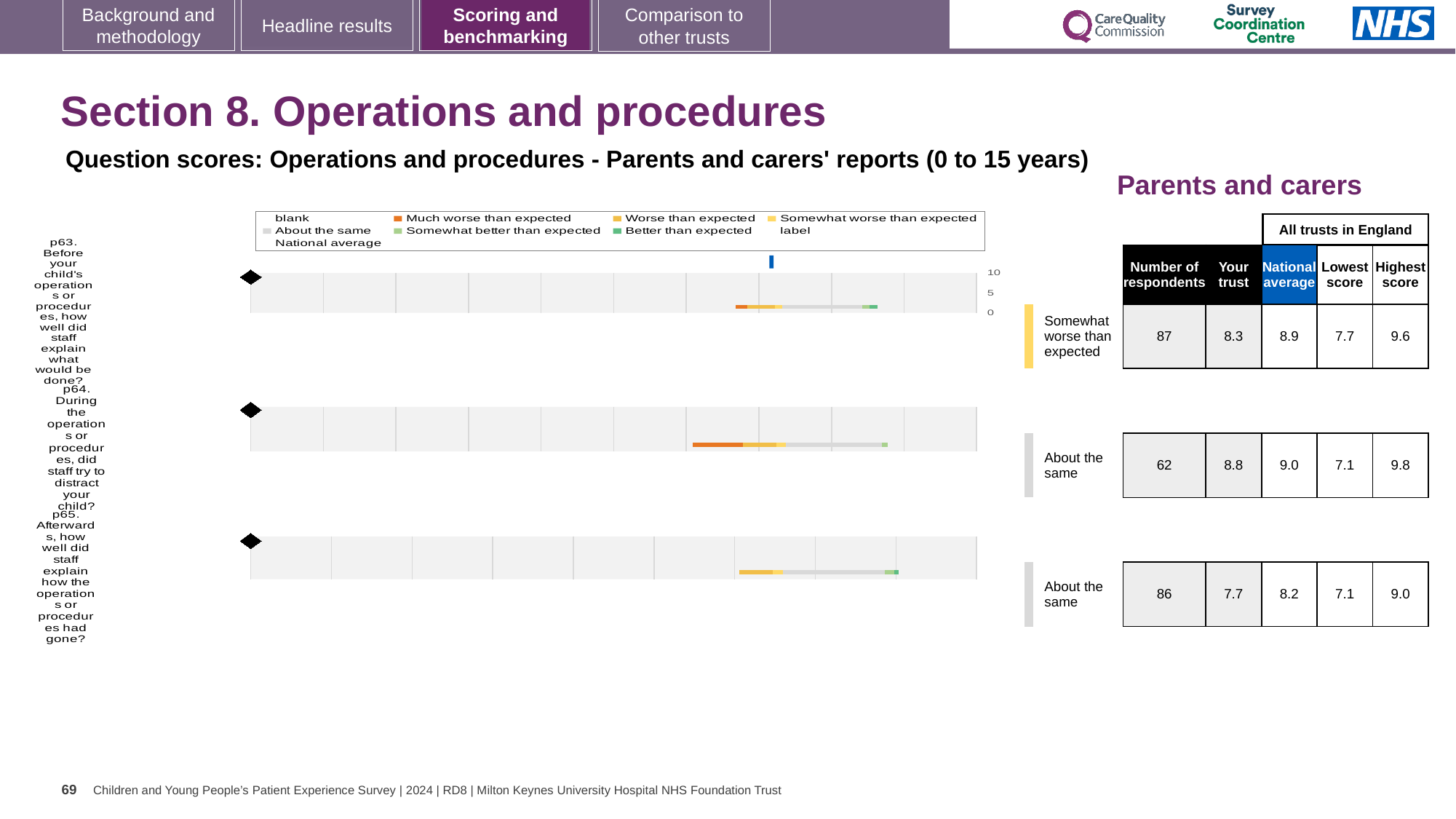
What benchmark category is shown for p64? About the same What kind of chart is used to show the question scores on this slide? bar chart How many questions (p63, p64, p65) are plotted on the slide? 3 Which question has the highest 'Your trust' score? p64 For p63, how much higher is the national average than the 'Your trust' score? 0.6 What is the highest score among all trusts in England for p64? 9.8 Which question has the lowest 'Your trust' score? p65 Which has the larger 'Your trust' score, p64 or p65? p64 How many respondents answered p65 (how well staff explained how the operation had gone)? 86 What is the national average score for p64 (did staff try to distract your child during the operation)? 9.0 What benchmark category is shown for p63? Somewhat worse than expected What is the 'Your trust' score for p63 (how well staff explained what would be done before the operation)? 8.3